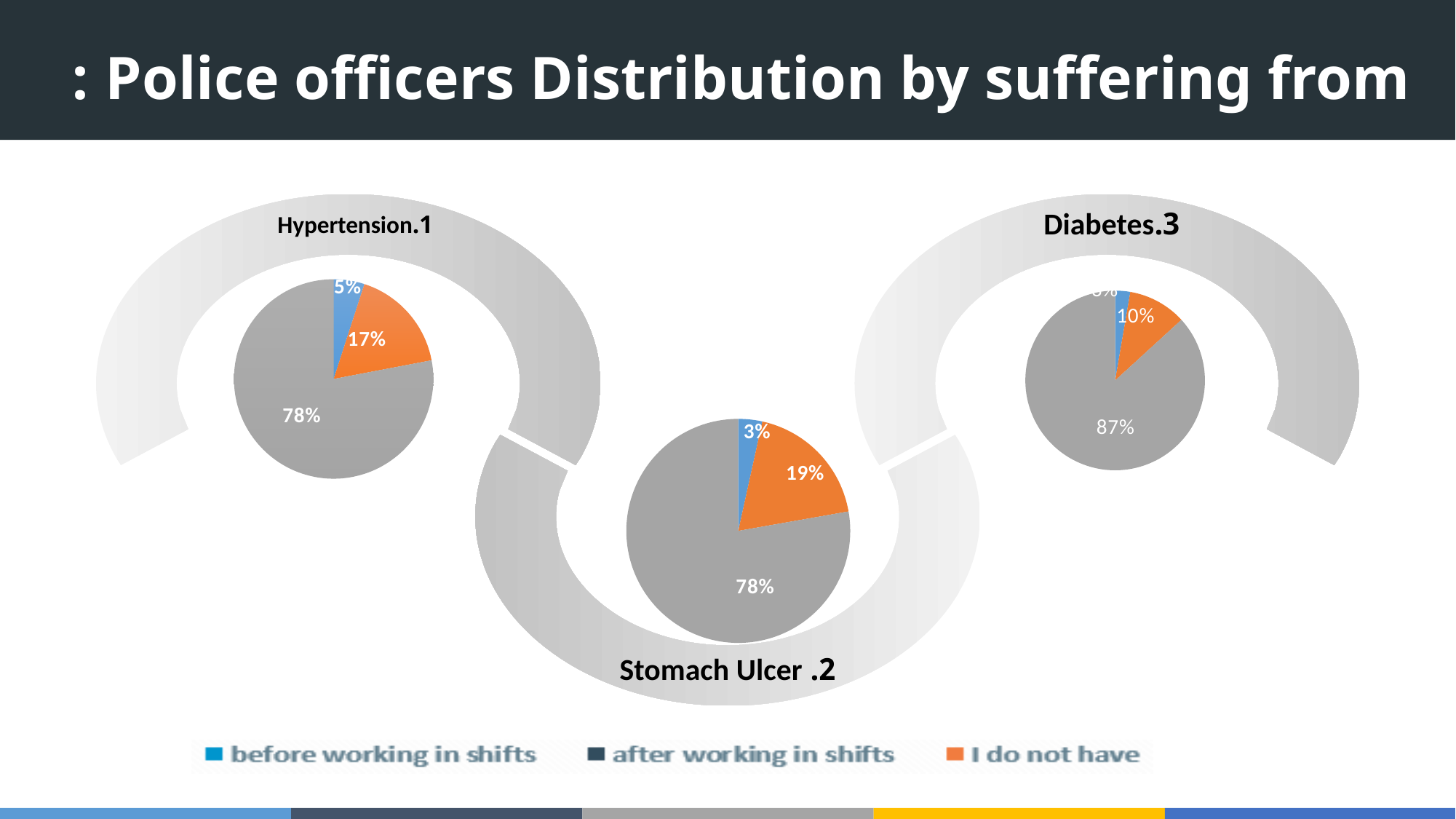
Which of the three pie charts has the largest grey slice? Diabetes In the Hypertension pie chart, what percentage is shown for the orange slice? 17% Which pie chart has the larger orange slice, Hypertension or Stomach Ulcer? Stomach Ulcer What kind of charts are shown on the slide? Pie charts How many entries does the legend list? 3 In the Stomach Ulcer pie chart, what percentage is shown for the blue slice? 3% What is the difference between the grey slice in the Diabetes pie chart and the grey slice in the Hypertension pie chart? 9% How many pie charts are on the slide? 3 In the Hypertension pie chart, what percentage is shown for the largest (grey) slice? 78% In the Diabetes pie chart, what percentage is shown for the grey slice? 87% In the Diabetes pie chart, what percentage is shown for the orange slice? 10% In the Stomach Ulcer pie chart, what percentage is shown for the orange slice? 19%